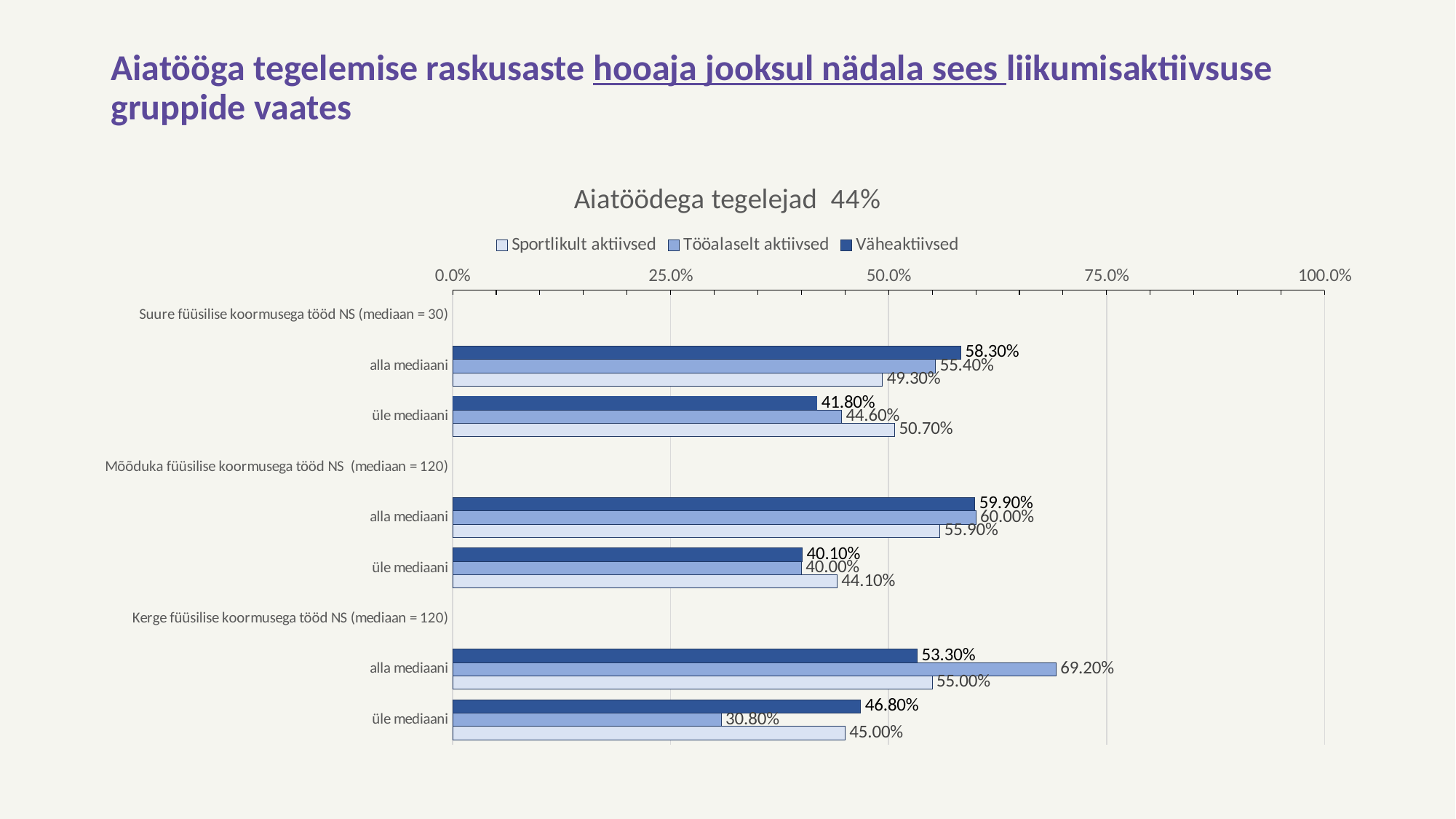
What is the title of the chart? Aiatöödega tegelejad 44% What kind of chart is shown on the slide? bar chart Under 'Suure füüsilise koormusega tööd NS (mediaan = 30)', which is larger for Sportlikult aktiivsed: 'alla mediaani' or 'üle mediaani'? üle mediaani How many series does the chart legend list? 3 Is the value for Tööalaselt aktiivsed in the 'üle mediaani' category under 'Kerge füüsilise koormusega tööd NS (mediaan = 120)' greater or less than 50.0%? less Which series has the lowest value in the 'üle mediaani' category under 'Kerge füüsilise koormusega tööd NS (mediaan = 120)'? Tööalaselt aktiivsed Which series has the highest value in the 'alla mediaani' category under 'Kerge füüsilise koormusega tööd NS (mediaan = 120)'? Tööalaselt aktiivsed What is the difference between the Väheaktiivsed values for 'alla mediaani' and 'üle mediaani' under 'Mõõduka füüsilise koormusega tööd NS (mediaan = 120)'? 19.80% What is the value for Väheaktiivsed in the 'alla mediaani' category under 'Suure füüsilise koormusega tööd NS (mediaan = 30)'? 58.30% What is the value for Tööalaselt aktiivsed in the 'alla mediaani' category under 'Kerge füüsilise koormusega tööd NS (mediaan = 120)'? 69.20% What is the value for Tööalaselt aktiivsed in the 'üle mediaani' category under 'Kerge füüsilise koormusega tööd NS (mediaan = 120)'? 30.80% What is the value for Sportlikult aktiivsed in the 'üle mediaani' category under 'Suure füüsilise koormusega tööd NS (mediaan = 30)'? 50.70%